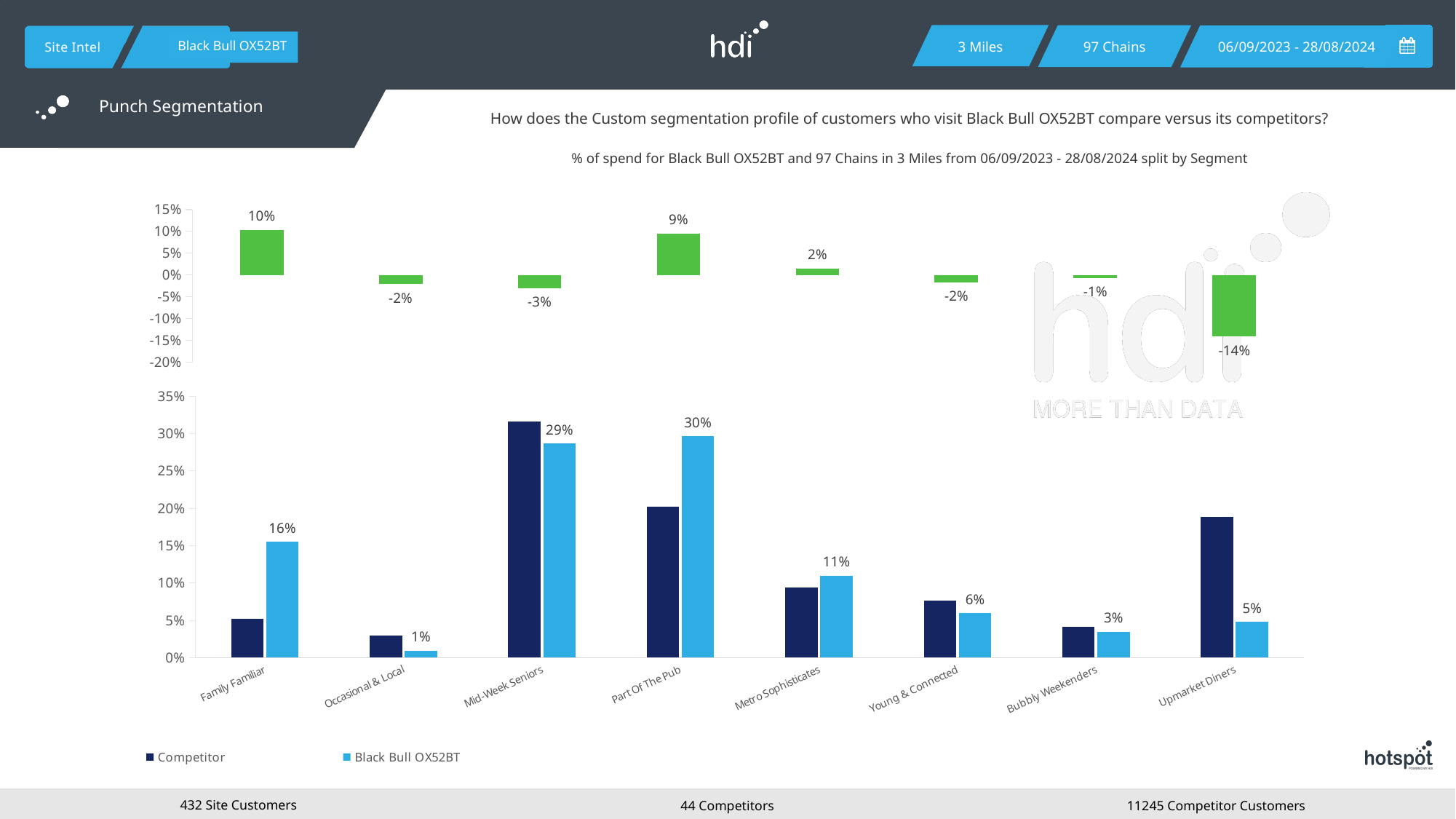
In the bottom chart, what is the value for Black Bull OX52BT in the Family Familiar segment? 16% In the bottom chart, which segment has the highest Black Bull OX52BT value? Part Of The Pub In the bottom chart, is the Competitor value for Upmarket Diners greater or less than 15%? greater In the bottom chart, for Mid-Week Seniors, which is larger: the Competitor bar or the Black Bull OX52BT bar? Competitor In the top chart, what is the value shown for Upmarket Diners? -14% In the top chart, which segment has the lowest value? Upmarket Diners In the bottom chart, which segment has the lowest Black Bull OX52BT value? Occasional & Local In the bottom chart, what is the difference between the Black Bull OX52BT values for Part Of The Pub and Metro Sophisticates? 19 percentage points How many series does the legend of the bottom chart list? 2 In the top chart, which segment has the highest value? Family Familiar How many segments are shown on the x axis of the bottom chart? 8 What kind of chart is the bottom chart? Bar chart